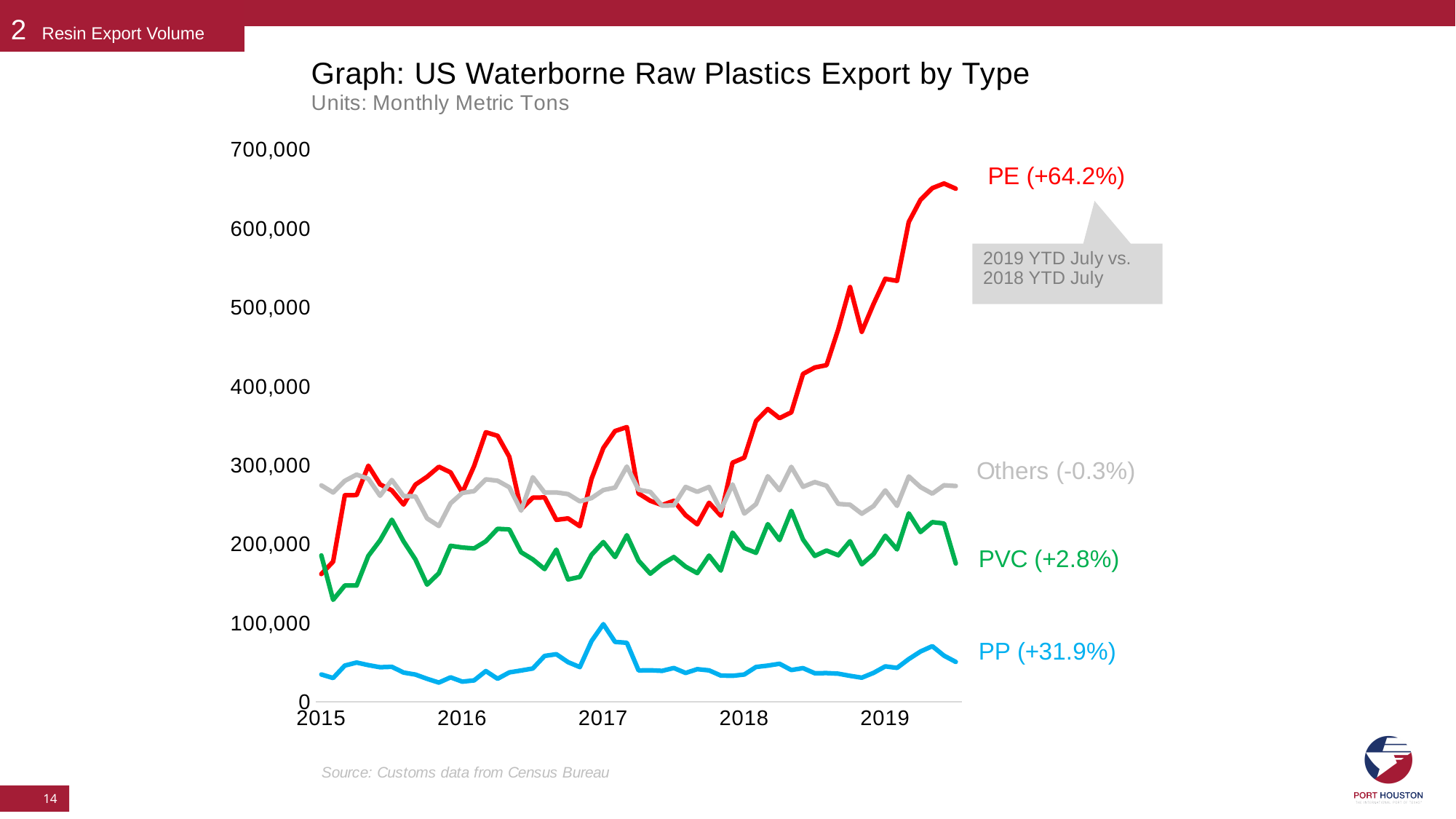
Which series has the highest value at the end of the chart in 2019? PE Does the PE series rise or fall from 2018 to 2019? Rise What percentage change is shown for PP? +31.9% Which series has the lowest values throughout the chart? PP What units does the chart use? Monthly Metric Tons Is the value for PE at the end of the chart in 2019 greater or less than 600,000? greater What kind of chart is shown on the slide? Line chart What percentage change is shown for PE (2019 YTD July vs. 2018 YTD July)? +64.2% What percentage change is shown for Others? -0.3% How many series are plotted on the chart? 4 What is the title of the chart? Graph: US Waterborne Raw Plastics Export by Type Is the value for PP at the start of 2015 greater or less than 100,000? less